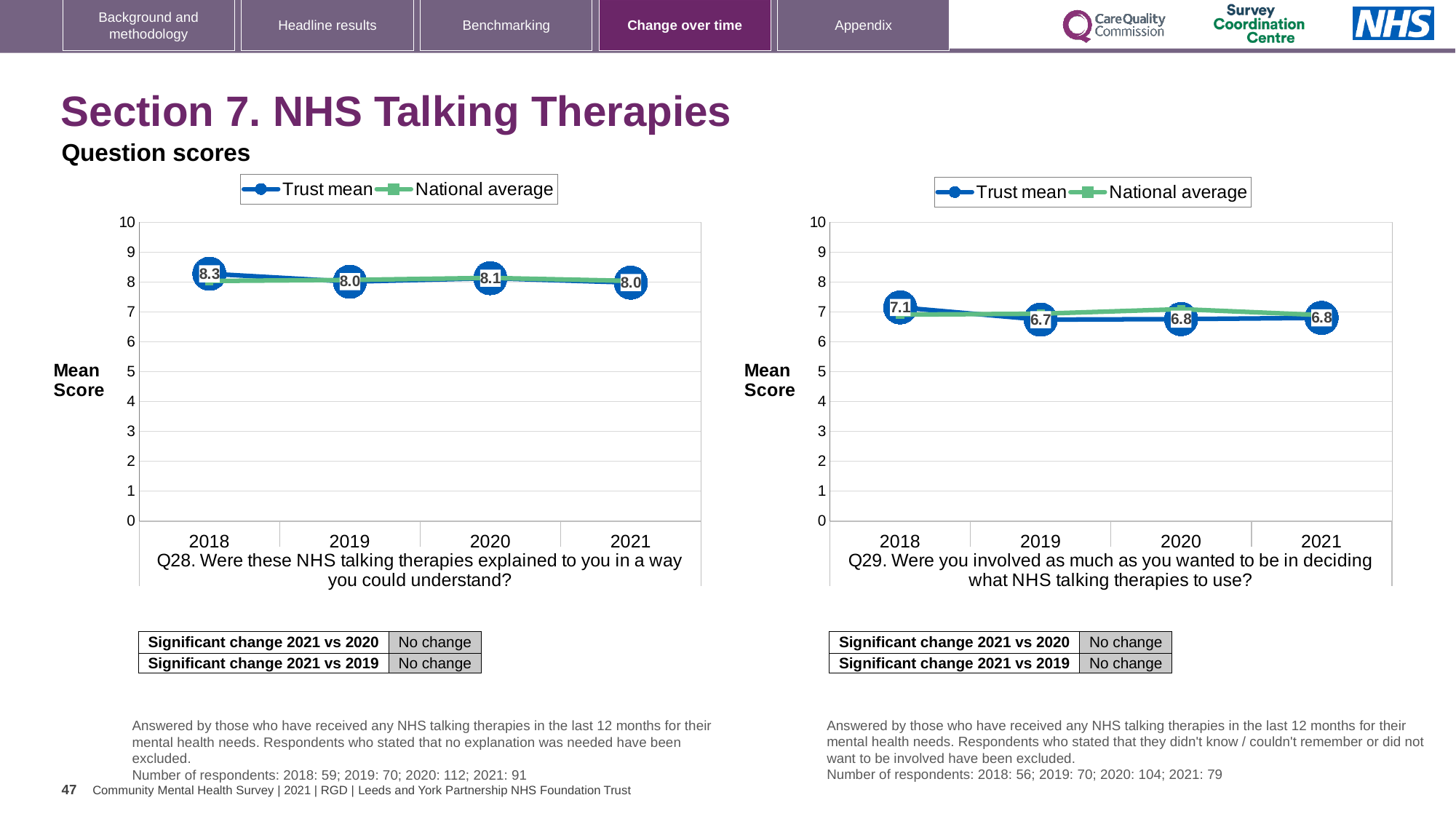
How many years are plotted on the x axis of the Q28 chart on the left? 4 In the Q29 chart on the right, which year has the lowest Trust mean score? 2019 How many series does the legend of the Q29 chart on the right list? 2 In the Q28 chart on the left, which year has the highest Trust mean score? 2018 In the Q28 chart on the left, what is the Trust mean score for 2018? 8.3 In the Q29 chart on the right, what is the Trust mean score for 2021? 6.8 In the Q28 chart on the left, is the Trust mean score higher in 2018 or in 2021? 2018 In the Q29 chart on the right, what is the Trust mean score for 2019? 6.7 In the Q29 chart on the right, what is the difference between the Trust mean scores for 2018 and 2019? 0.4 In the Q28 chart on the left, what is the Trust mean score for 2020? 8.1 What type of chart is the Q28 chart on the left? Line chart In the Q29 chart on the right, does the Trust mean score rise or fall from 2018 to 2021? Fall